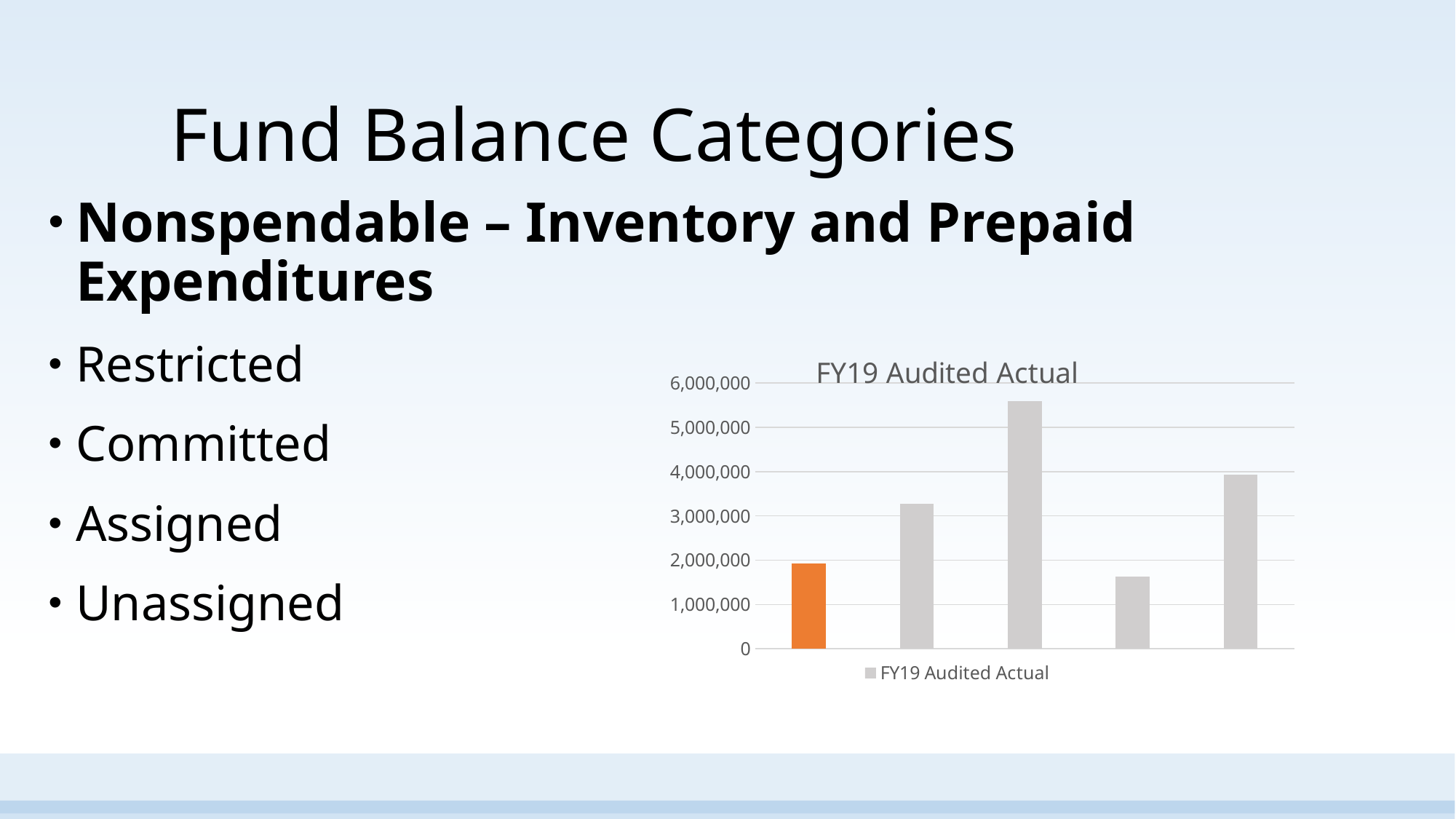
Is the value of the fourth bar greater or less than 2,000,000? less Is the value of the first (orange) bar greater or less than 3,000,000? less Which is larger, the second bar or the fifth bar? the fifth bar Which bar in the chart is the tallest? the third bar What kind of chart is shown on the slide? bar chart How many bars are plotted in the chart? 5 Which bar is the only one coloured orange rather than grey? the first (leftmost) bar Is the value of the third bar greater or less than 5,000,000? greater Which bar in the chart is the shortest? the fourth bar How many series does the chart legend list? 1 What is the title of the chart? FY19 Audited Actual